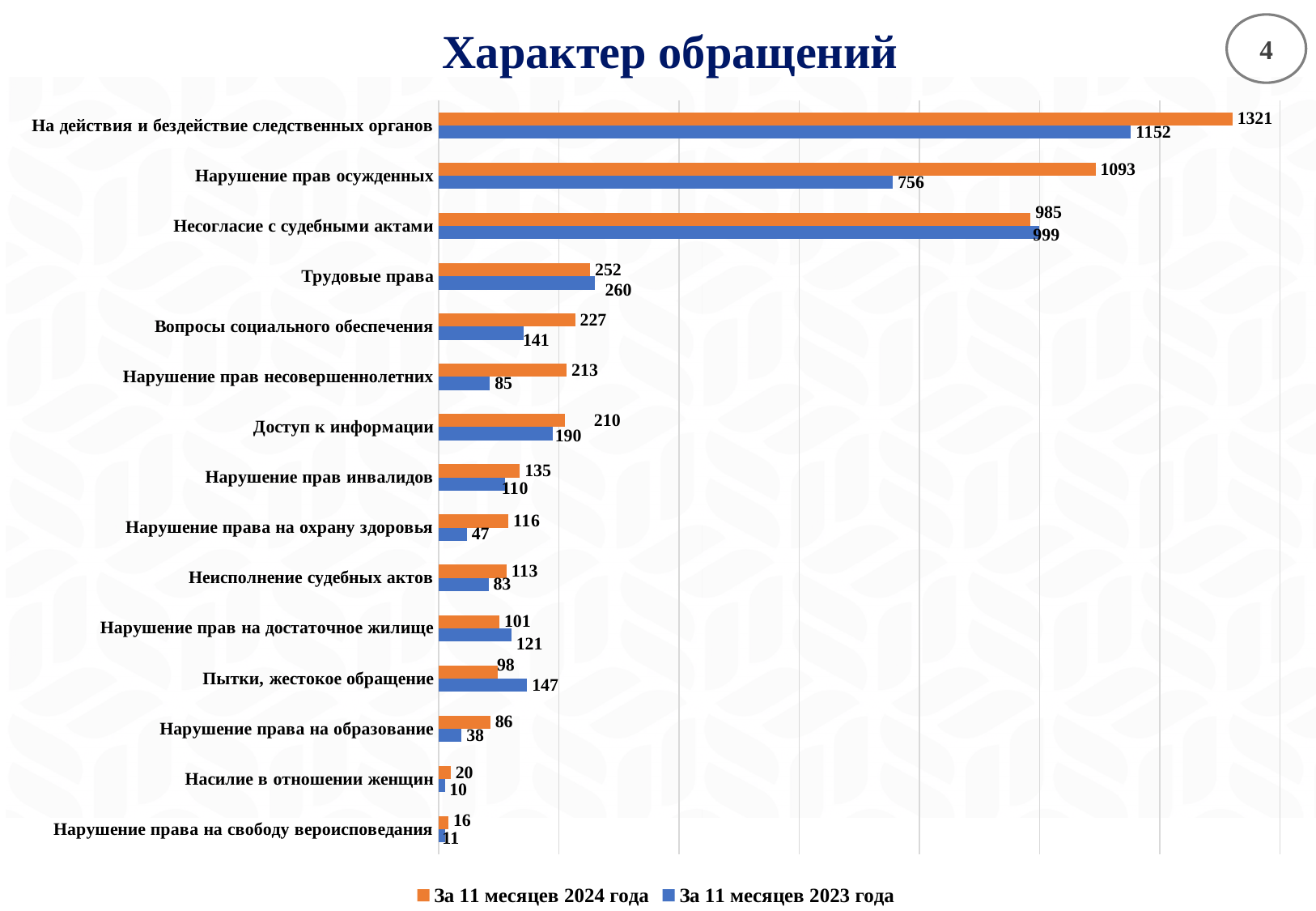
How many series does the legend list? 2 For "Несогласие с судебными актами", which series has the larger value: "За 11 месяцев 2024 года" or "За 11 месяцев 2023 года"? За 11 месяцев 2023 года Which category has the highest value in the series "За 11 месяцев 2024 года"? На действия и бездействие следственных органов How many categories are shown on the chart? 15 What is the value for "Нарушение прав осужденных" in the series "За 11 месяцев 2024 года"? 1093 What kind of chart is shown on the slide? Bar chart What is the difference between the 2024 and 2023 values for "Нарушение права на охрану здоровья"? 69 What is the value for "Пытки, жестокое обращение" in the series "За 11 месяцев 2023 года"? 147 What is the title of the chart? Характер обращений Which category has the lowest value in the series "За 11 месяцев 2023 года"? Насилие в отношении женщин Which colour represents the series "За 11 месяцев 2023 года"? Blue What is the difference between the 2024 and 2023 values for "Нарушение прав осужденных"? 337